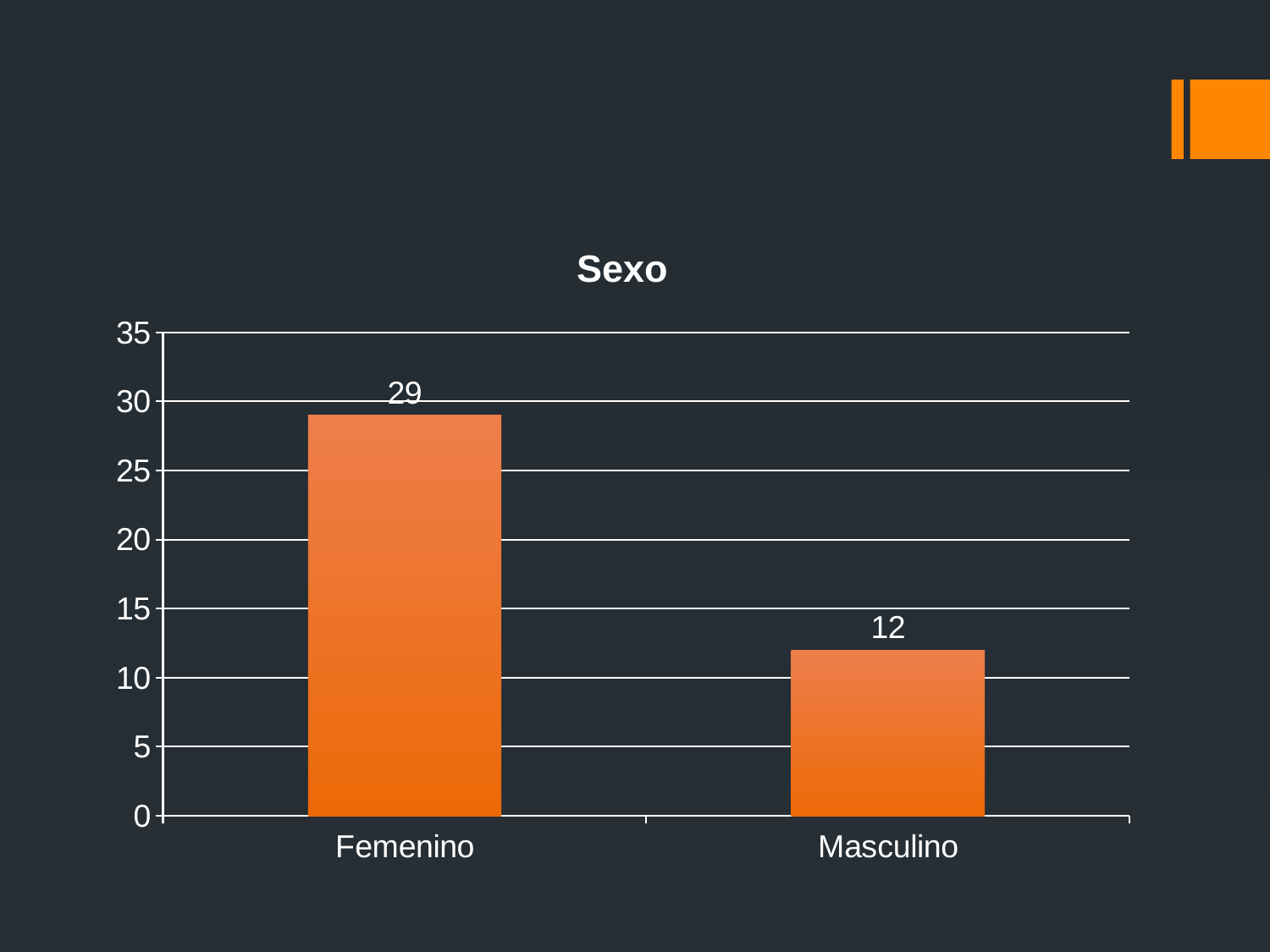
What is the title of the chart? Sexo What is the value for Masculino? 12 Which category has the lowest value? Masculino Is the value for Femenino greater or less than 25? greater Is the value for Masculino greater or less than 15? less What is the difference between the values for Femenino and Masculino? 17 How many categories are shown on the x axis? 2 Which category has the highest value? Femenino What is the value for Femenino? 29 What is the total of the two values shown in the chart? 41 Which is larger, the value for Femenino or the value for Masculino? Femenino What kind of chart is shown on the slide? bar chart